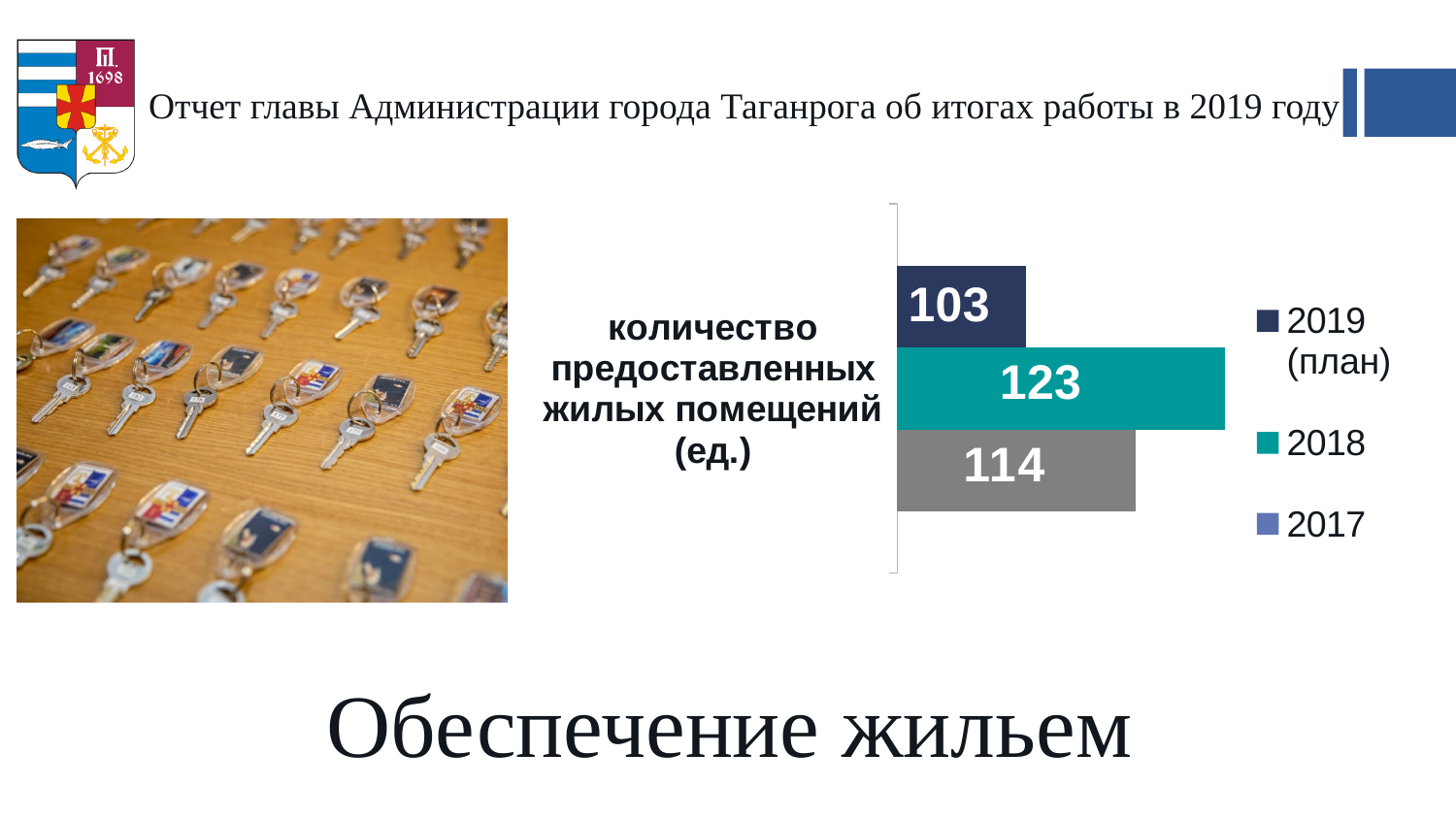
What kind of chart is shown on the slide? bar chart What is the difference between the 2017 value and the 2019 (план) value? 11 How many series does the legend list? 3 What is the category label shown to the left of the bars? количество предоставленных жилых помещений (ед.) What colour is the bar for 2018? teal What is the value for 2017 in the chart? 114 What is the difference between the 2018 value and the 2017 value? 9 Which year has the highest value in the chart? 2018 Which is larger, the value for 2017 or the value for 2019 (план)? 2017 Which series has the lowest value in the chart? 2019 (план) What is the value for 2018 in the chart of количество предоставленных жилых помещений? 123 What is the value for 2019 (план) in the chart? 103